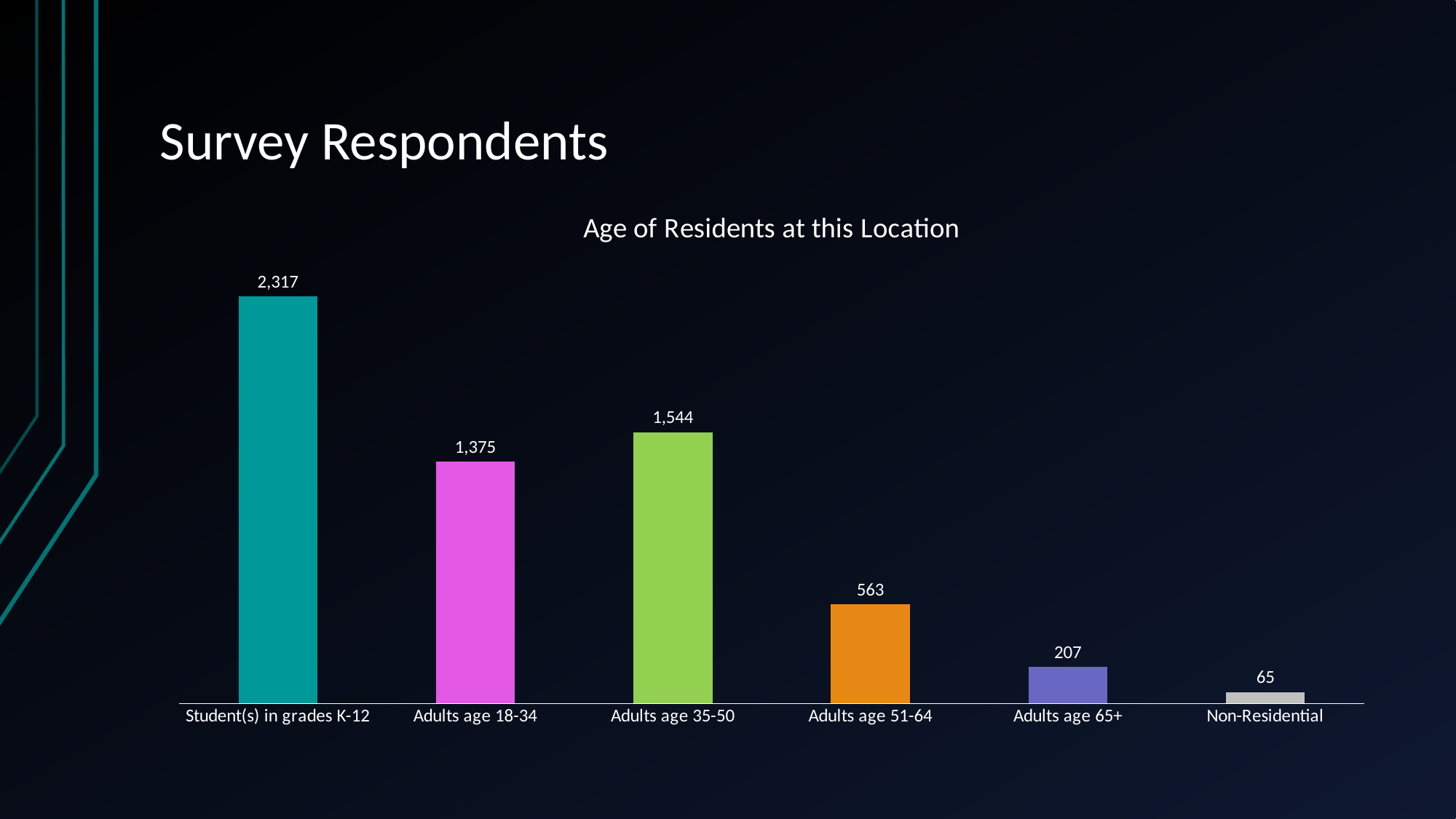
Which category has the lowest value? Non-Residential What is the difference between the values for Adults age 35-50 and Adults age 18-34? 169 What is the value for Non-Residential? 65 What is the value for Adults age 65+? 207 How many categories are shown in the chart? 6 What is the value for Student(s) in grades K-12? 2,317 Which is larger, the value for Adults age 18-34 or Adults age 35-50? Adults age 35-50 Which category has the highest value? Student(s) in grades K-12 What is the value for Adults age 35-50? 1,544 What is the difference between the values for Adults age 51-64 and Adults age 65+? 356 What is the title of the chart? Age of Residents at this Location What kind of chart is shown on the slide? Bar chart